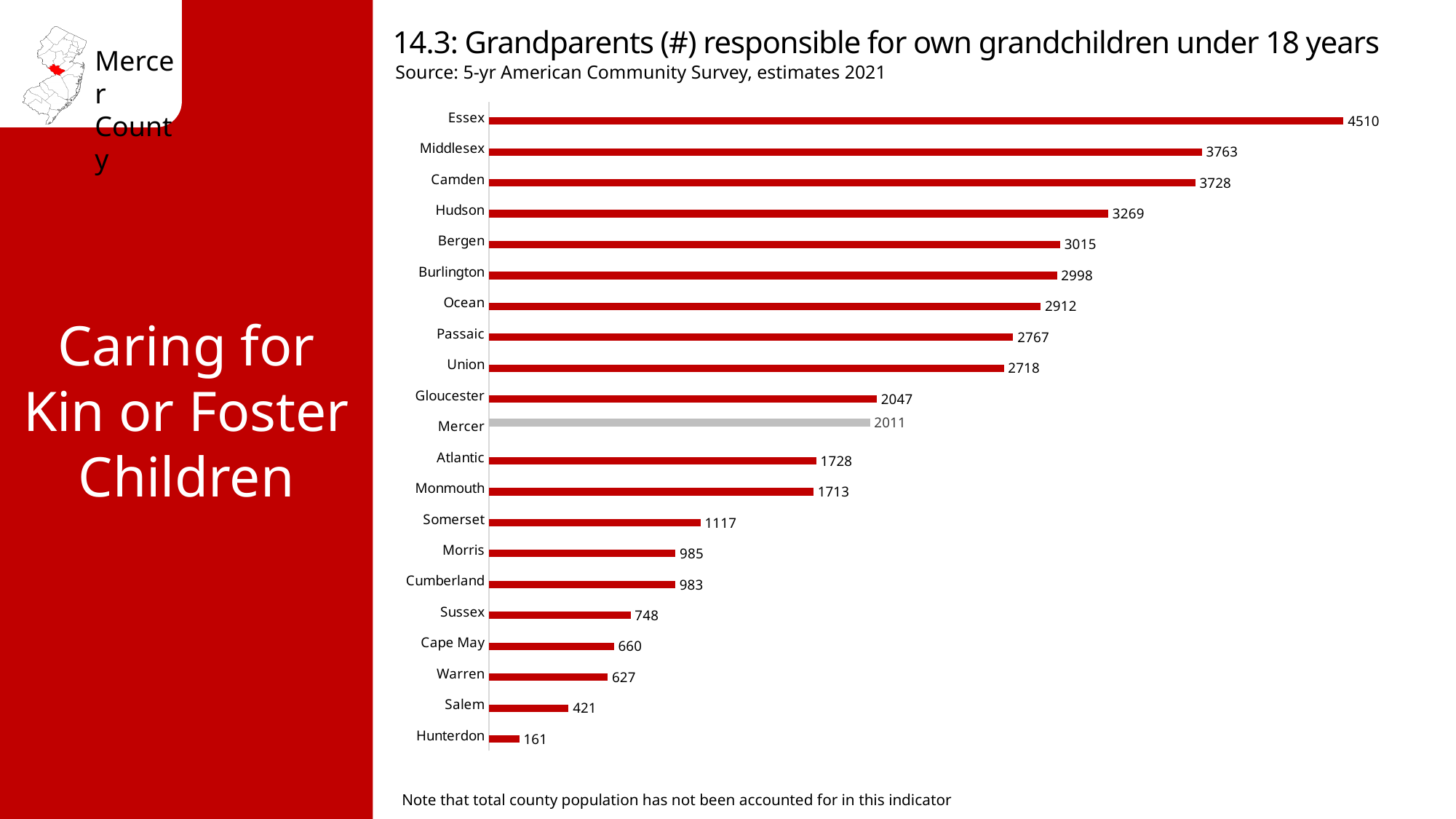
Which is larger, the value for Bergen or the value for Ocean? Bergen How many counties are shown in the chart? 21 What is the difference between the values for Essex and Middlesex? 747 What is the value for Hudson? 3269 Which county's bar is shown in grey rather than red? Mercer What is the difference between the values for Gloucester and Mercer? 36 What is the value for Cape May? 660 Which is larger, the value for Somerset or the value for Sussex? Somerset Which county has the lowest value? Hunterdon What kind of chart is this? Bar chart What is the value for Mercer? 2011 Which county has the highest value? Essex